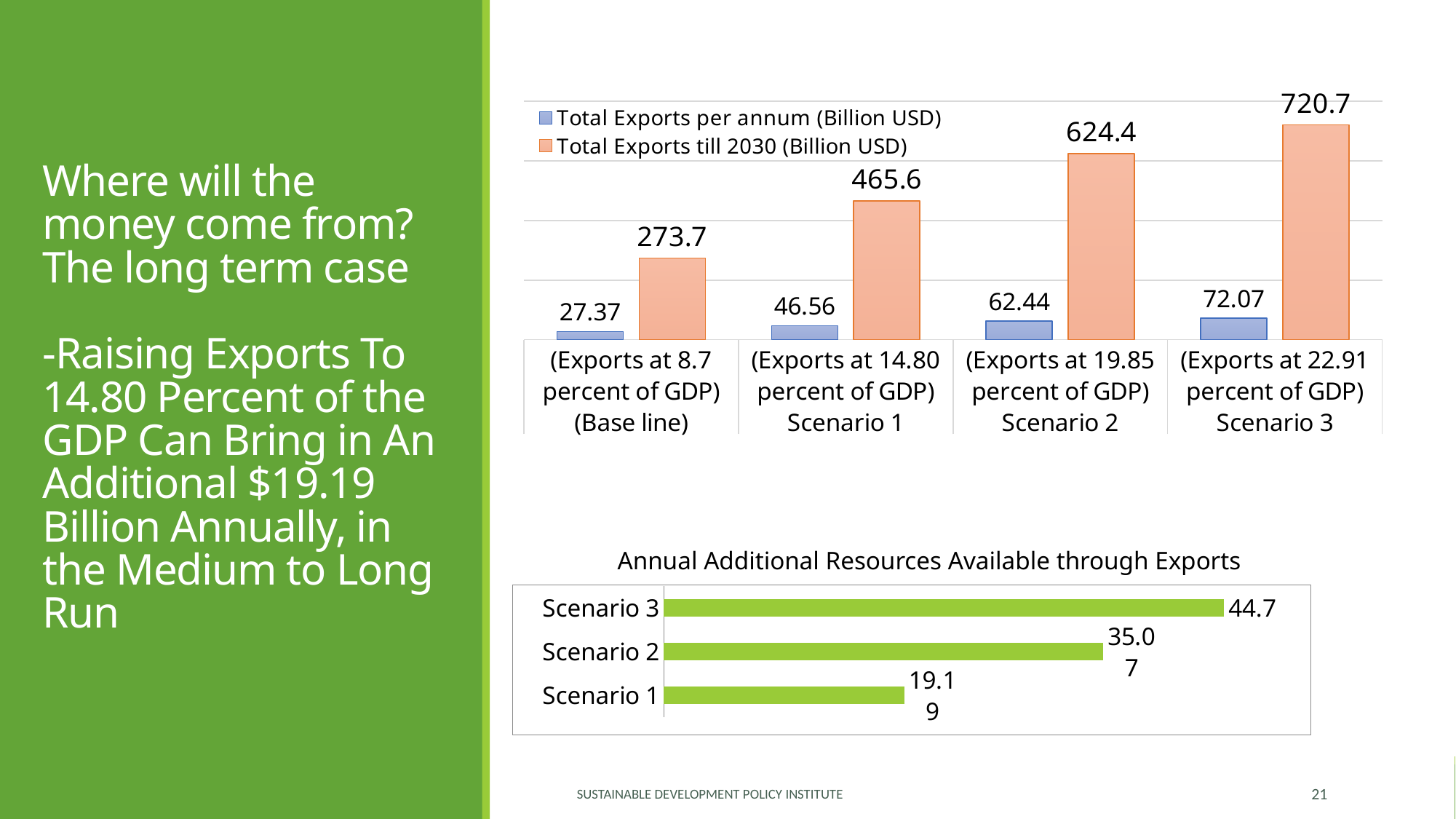
In the top chart, what is the difference in Total Exports per annum (Billion USD) between Scenario 2 and the Base line? 35.07 In the top chart, which category has the highest Total Exports till 2030 (Billion USD)? (Exports at 22.91 percent of GDP) Scenario 3 What kind of chart is 'Annual Additional Resources Available through Exports'? bar chart In the top chart, how many categories are shown on the x axis? 4 In the chart titled 'Annual Additional Resources Available through Exports', which scenario has the lowest value? Scenario 1 In the top chart, what is the value of Total Exports till 2030 (Billion USD) for Scenario 3 (Exports at 22.91 percent of GDP)? 720.7 In the chart titled 'Annual Additional Resources Available through Exports', what is the value for Scenario 3? 44.7 In the top chart, do the Total Exports till 2030 (Billion USD) values rise or fall from the Base line to Scenario 3? rise In the top chart, what is the value of Total Exports per annum (Billion USD) for Scenario 1 (Exports at 14.80 percent of GDP)? 46.56 In the top chart, what is the value of Total Exports till 2030 (Billion USD) for the Base line (Exports at 8.7 percent of GDP)? 273.7 In the top chart, how many series does the legend list? 2 In the top chart, which category has the lowest Total Exports per annum (Billion USD)? (Exports at 8.7 percent of GDP) (Base line)